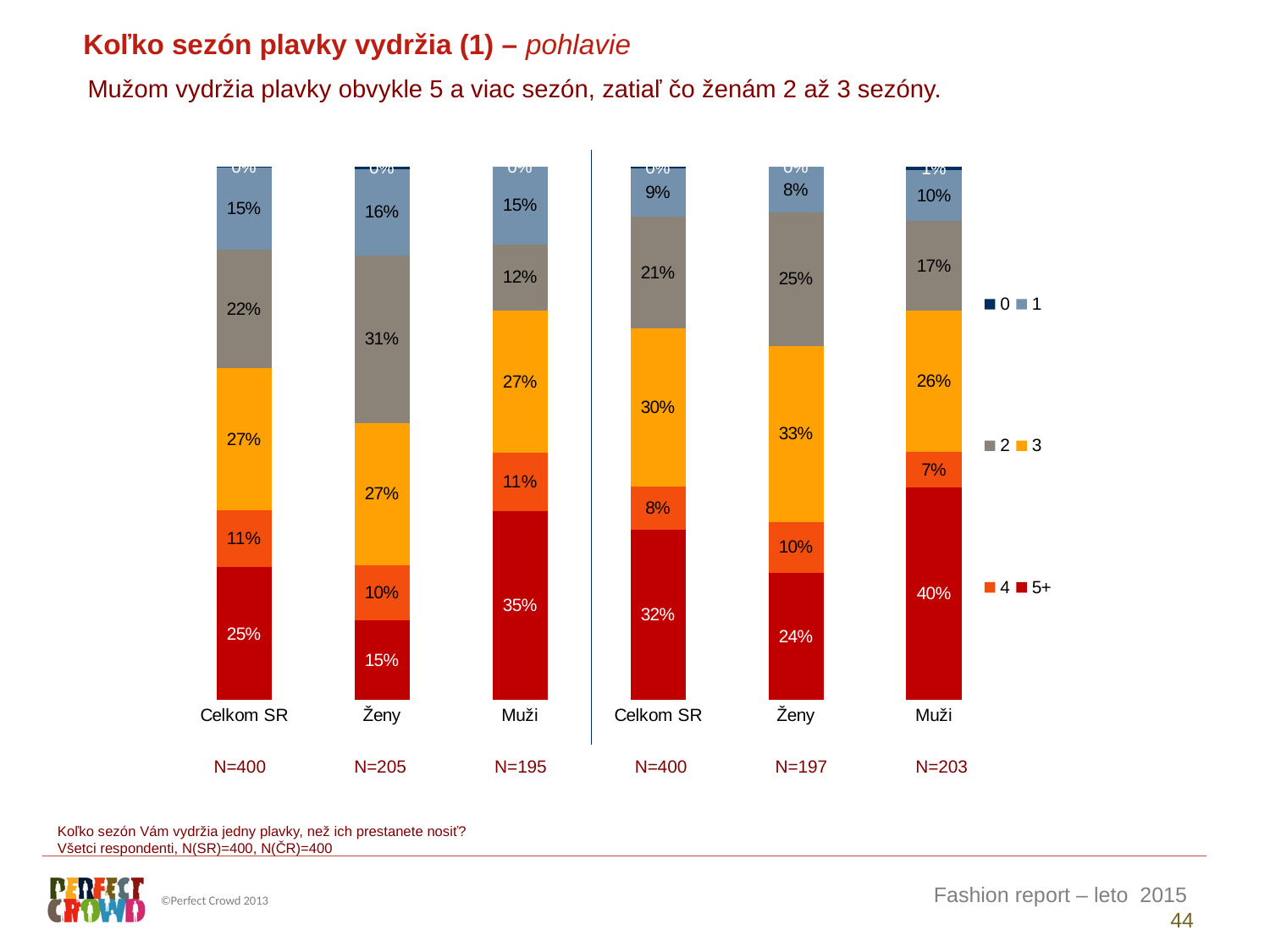
How many categories are shown on the x axis of the left chart? 3 In the left chart, what is the difference between the 5+ values for Muži and Ženy? 20% In the right chart, which category has the lowest 5+ value? Ženy In the right chart, which is larger: the 2 segment for Ženy or the 2 segment for Muži? Ženy In the left chart, what is the value of the 5+ segment for Muži? 35% In the left chart, which category has the highest 5+ value? Muži How many series does the legend list? 6 In the right chart, what is the value of the 3 segment for Ženy? 33% In the left chart, what is the value of the 2 segment for Ženy? 31% In the right chart, what is the sample size (N) shown for Muži? N=203 What kind of chart is shown on the slide? Stacked bar chart In the right chart, what is the value of the 5+ segment for Muži? 40%